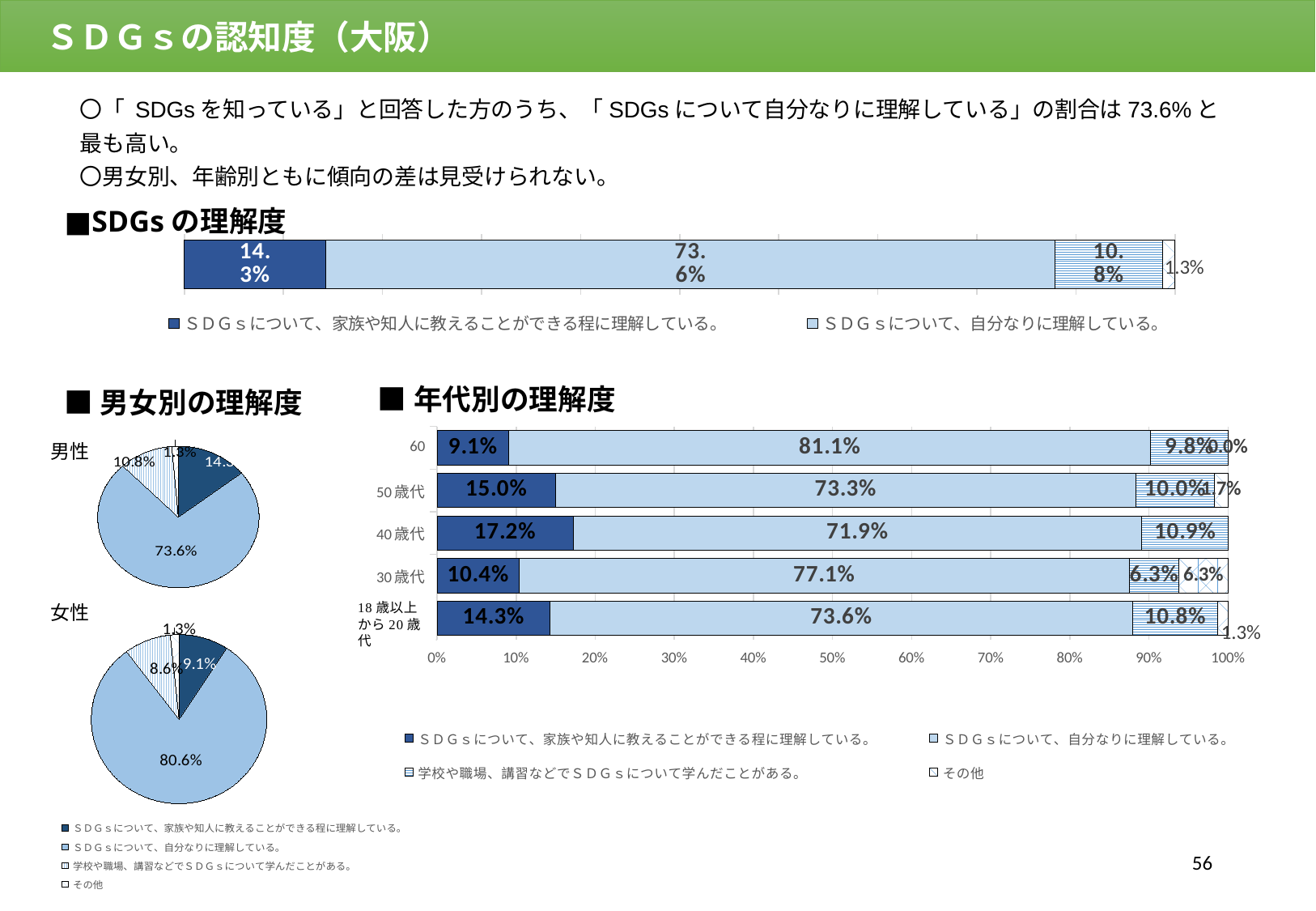
What kind of chart is the 年代別の理解度 chart? Stacked horizontal bar chart In the 女性 pie chart, what share is 'ＳＤＧｓについて、自分なりに理解している。'? 80.6% In the 年代別の理解度 chart, is the value for 40歳代 in 'ＳＤＧｓについて、家族や知人に教えることができる程に理解している。' greater or less than 20%? less In the 年代別の理解度 chart, what is the value for 40歳代 in the series 'ＳＤＧｓについて、自分なりに理解している。'? 71.9% In the 年代別の理解度 chart, which age group has the highest value for 'ＳＤＧｓについて、家族や知人に教えることができる程に理解している。'? 40歳代 In the top SDGsの理解度 bar chart, what is the value for 'ＳＤＧｓについて、自分なりに理解している。'? 73.6% In the 年代別の理解度 chart, what is the difference between 50歳代 and 30歳代 for 'ＳＤＧｓについて、家族や知人に教えることができる程に理解している。'? 4.6 percentage points How many age categories are shown in the 年代別の理解度 chart? 5 Comparing the 男性 and 女性 pie charts, which has the larger share for 'ＳＤＧｓについて、自分なりに理解している。'? 女性 In the 男性 pie chart, what is the value for '学校や職場、講習などでＳＤＧｓについて学んだことがある。'? 10.8% In the 年代別の理解度 chart, which age group has the highest value for 'ＳＤＧｓについて、自分なりに理解している。'? 60 How many series does the legend of the 年代別の理解度 chart list? 4